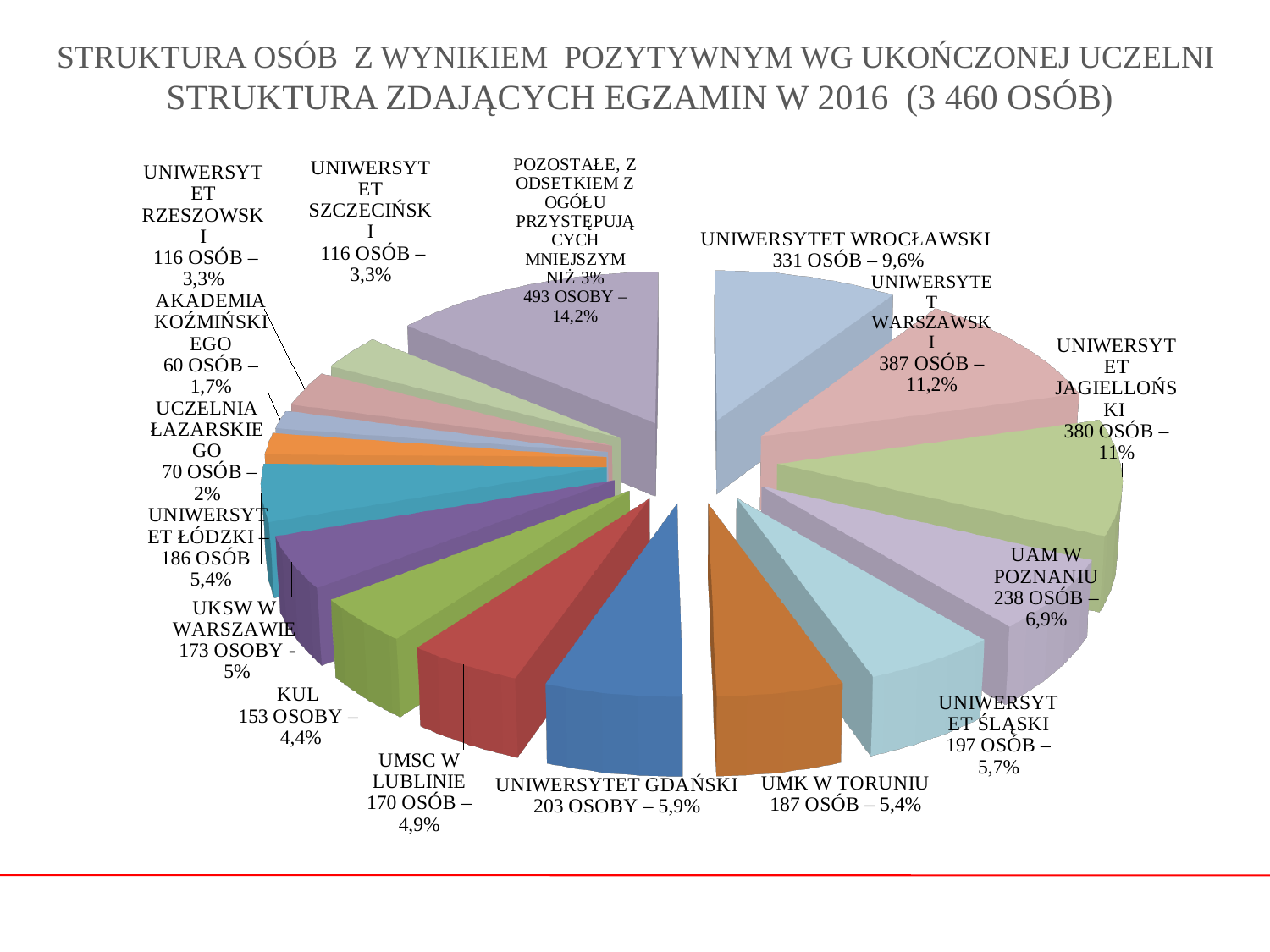
What kind of chart is shown on the slide? pie chart How many people are shown for KUL? 153 osoby What percentage is shown for Uczelnia Łazarskiego? 2% Which slice of the pie is the largest? Pozostałe (493 osoby – 14,2%) What percentage is shown for UAM w Poznaniu? 6,9% Which has more people: Uniwersytet Gdański or UMK w Toruniu? Uniwersytet Gdański What is the difference in number of people between Uniwersytet Warszawski and Uniwersytet Jagielloński? 7 How many slices does the pie chart have? 16 What share of the pie does Uniwersytet Jagielloński hold? 11% Which slice of the pie is the smallest? Akademia Koźmińskiego (60 osób – 1,7%) How many people passed from Uniwersytet Warszawski according to the chart? 387 osób What total number of people is given in the chart title for those taking the exam in 2016? 3 460 osób